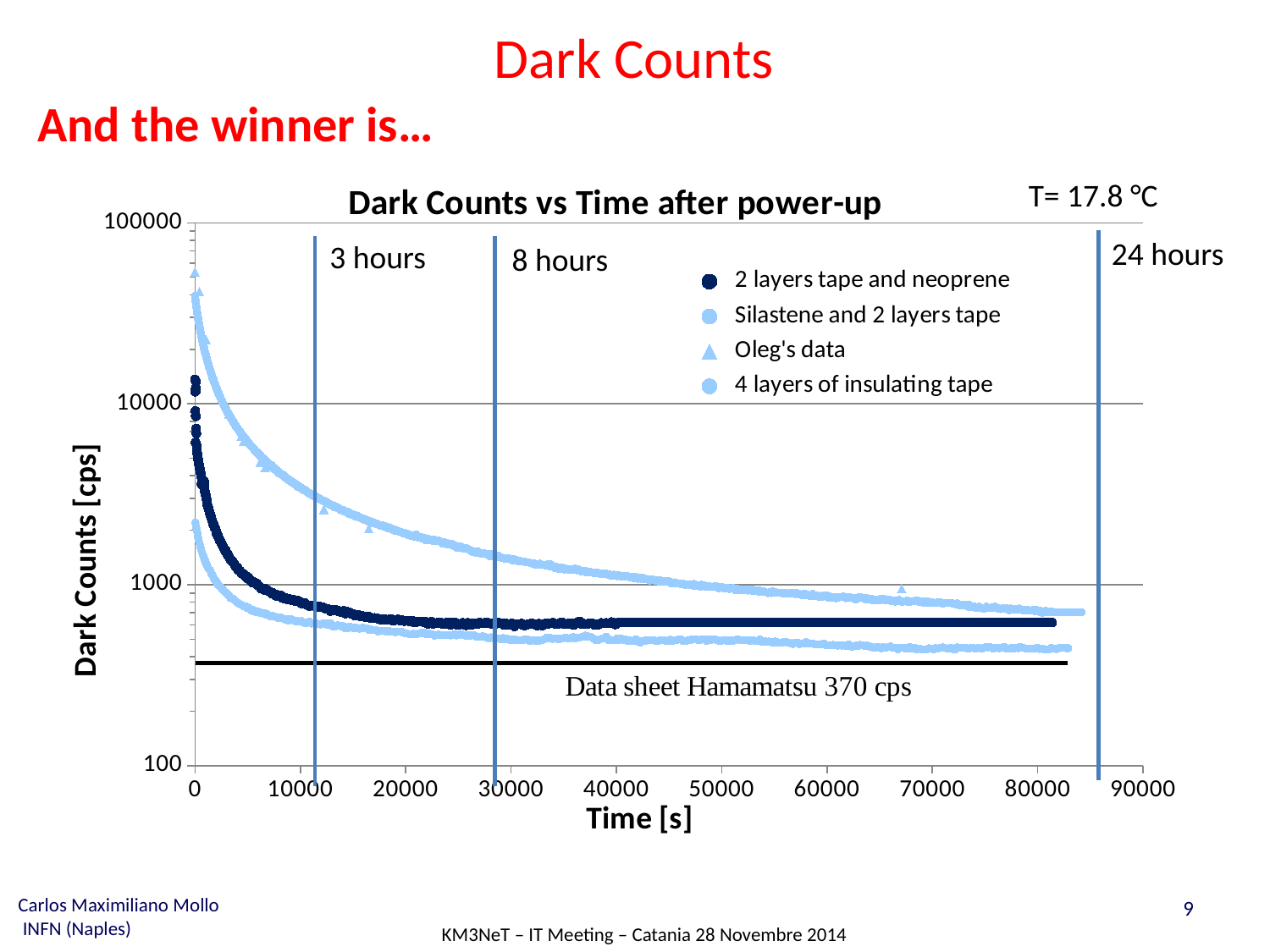
What is the highest tick value shown on the x axis? 90000 What is the title of the chart? Dark Counts vs Time after power-up What kind of chart is shown on the slide? scatter chart Is the value for '2 layers tape and neoprene' at 80000 s greater or less than 1000? less At 80000 s, is the '2 layers tape and neoprene' series above or below the Data sheet Hamamatsu 370 cps line? above Is the value for '2 layers tape and neoprene' at 80000 s greater or less than 100? greater How many series does the legend list? 4 Is the first value of 'Oleg's data' near 0 s greater or less than 10000? greater What dark count value does the Data sheet Hamamatsu reference line indicate? 370 cps What is the label of the y axis? Dark Counts [cps] At around 10000 s, which is larger: 'Oleg's data' or '2 layers tape and neoprene'? Oleg's data Do the dark counts rise or fall as time after power-up increases? fall